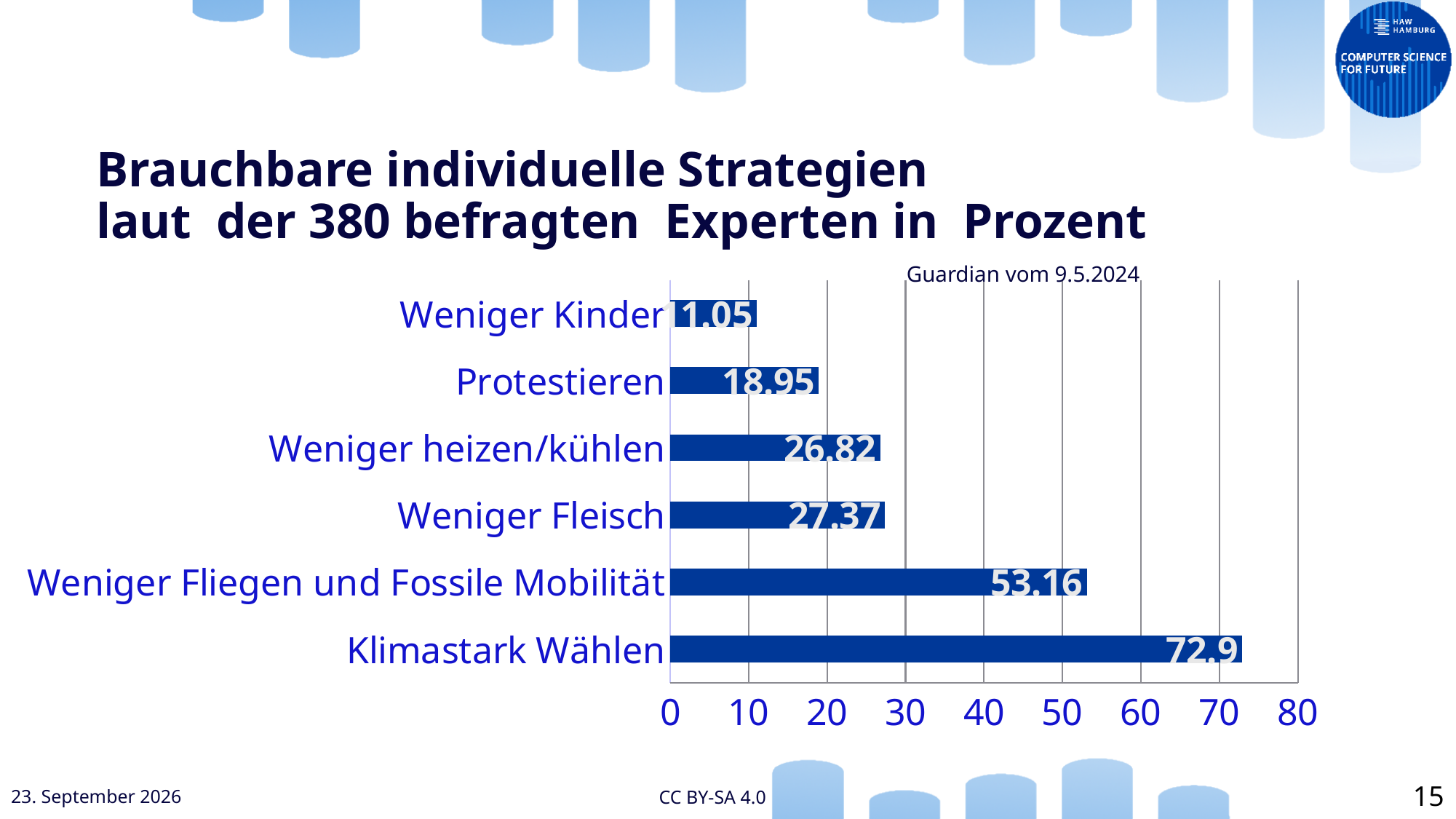
What is the difference between the values for Klimastark Wählen and Weniger Fliegen und Fossile Mobilität? 19.74 What is the value for Weniger heizen/kühlen? 26.82 What is the value for Weniger Fliegen und Fossile Mobilität? 53.16 What is the value for Klimastark Wählen? 72.9 What type of chart is shown on the slide? bar chart Is the value for Weniger Kinder greater or less than 20? less How many categories are shown in the chart? 6 Which category has the highest value? Klimastark Wählen Which category has the lowest value? Weniger Kinder What is the value for Protestieren? 18.95 Which is larger, the value for Protestieren or the value for Weniger Fleisch? Weniger Fleisch What is the difference between the values for Weniger Fleisch and Weniger heizen/kühlen? 0.55